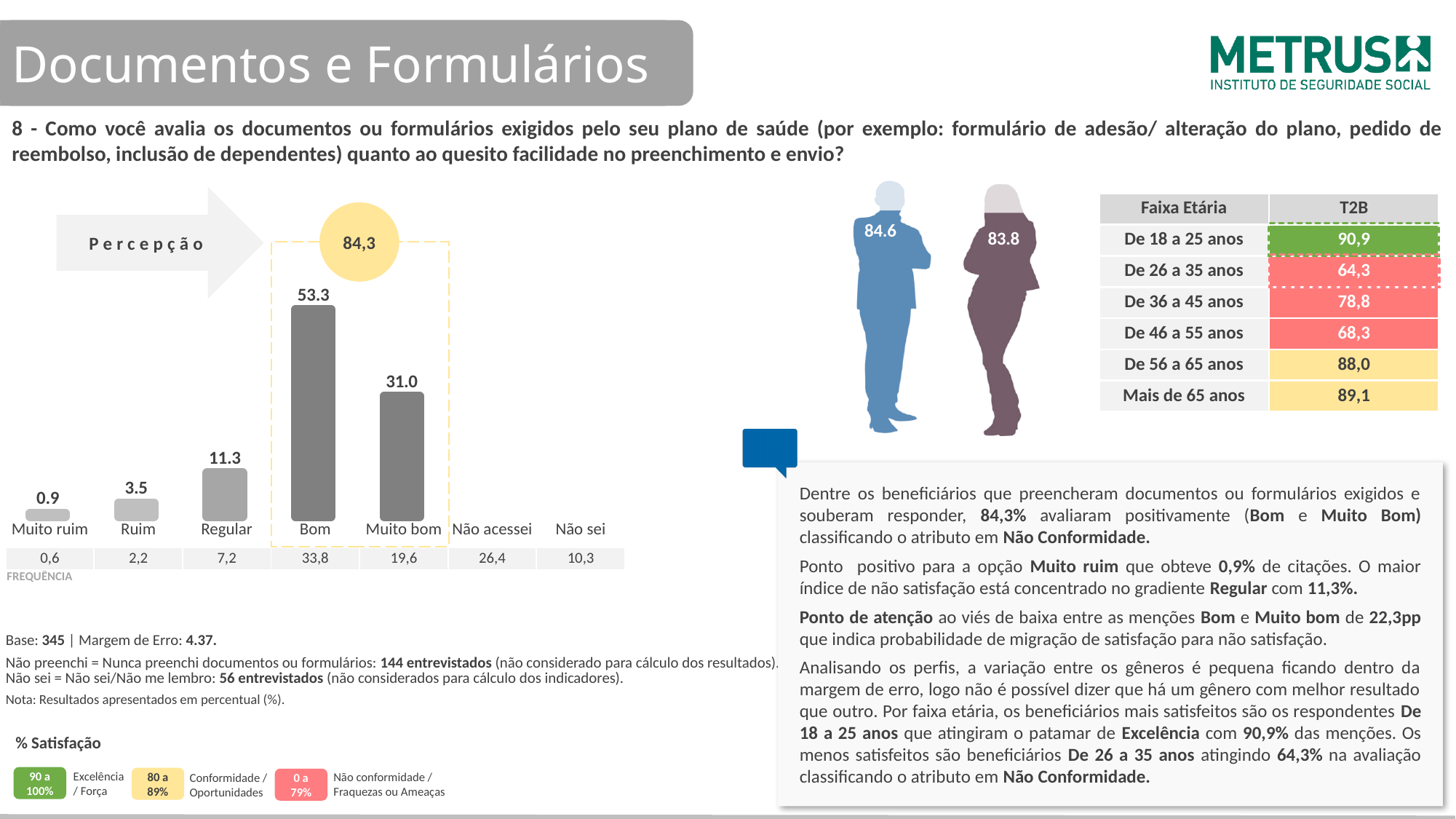
Which is larger in the bar chart, Ruim or Regular? Regular What kind of chart is shown on the left of the slide? Bar chart What is the difference between the values for Regular and Ruim in the bar chart? 7.8 What is the value for Muito ruim in the bar chart? 0.9 What is the frequency value shown below the Bom category in the bar chart? 33,8 What is the value for Muito bom in the bar chart? 31.0 What is the combined value shown in the yellow circle above the Bom and Muito bom bars? 84,3 What is the difference between the values for Bom and Muito bom in the bar chart? 22.3 What is the value for Regular in the bar chart? 11.3 Which category with a plotted bar has the lowest value in the chart? Muito ruim Which category has the highest bar in the chart? Bom What is the value for Bom in the bar chart? 53.3